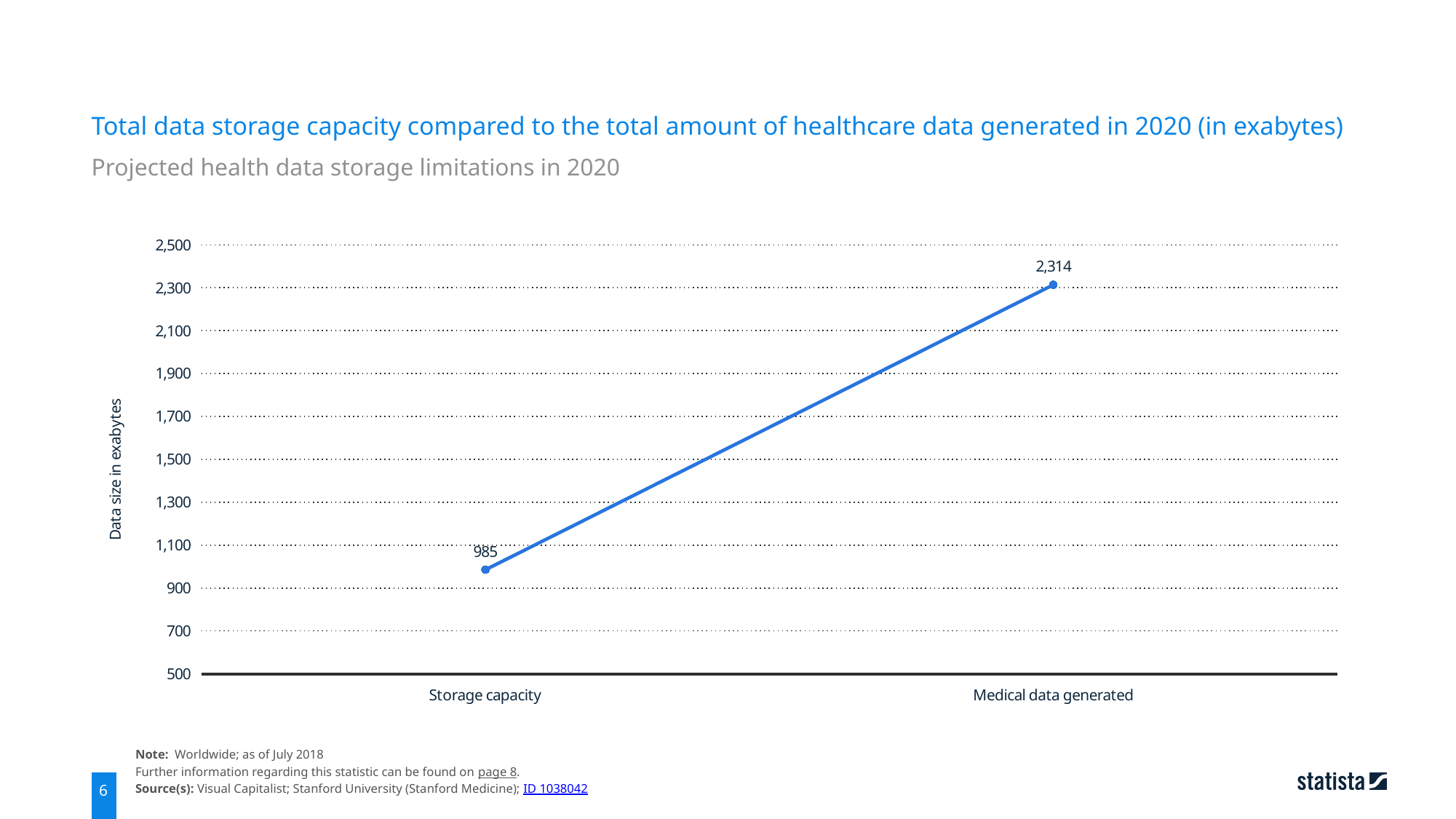
Is the value for Storage capacity greater or less than 1,100? less How many categories are plotted on the x axis? 2 What is the value for Medical data generated? 2,314 Which category has the lowest value? Storage capacity What is the difference between Medical data generated and Storage capacity? 1,329 What is the value for Storage capacity? 985 Which is larger, Storage capacity or Medical data generated? Medical data generated Is the value for Medical data generated greater or less than 2,100? greater What kind of chart is shown? line chart Which category has the highest value? Medical data generated Do the values rise or fall from Storage capacity to Medical data generated? rise What is the label of the y axis? Data size in exabytes